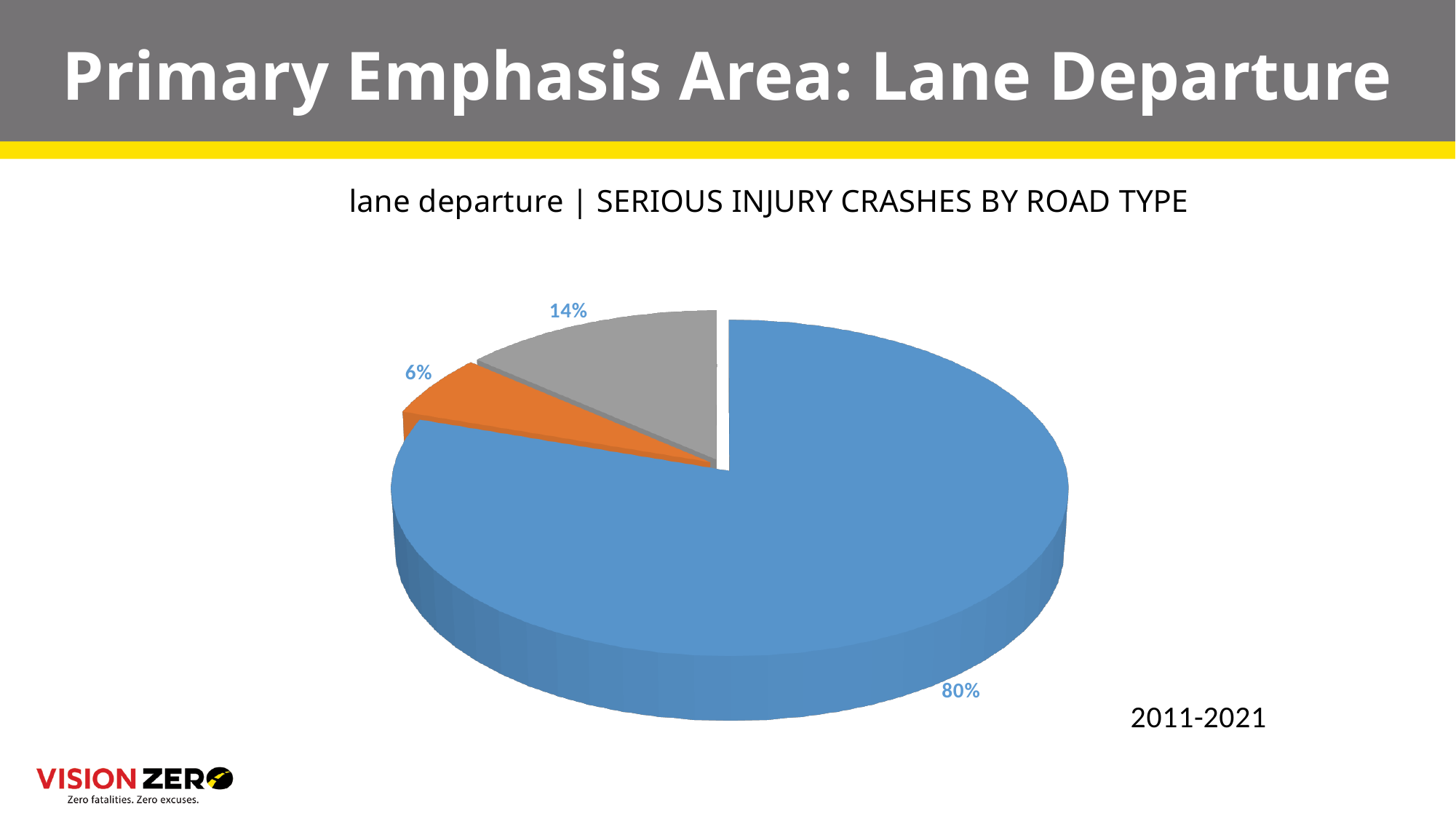
Which is larger, the grey slice or the orange slice? grey slice Which colour slice represents the smallest share of the pie chart? orange What percentage is shown for the grey slice of the pie chart? 14% What time period is shown next to the pie chart? 2011-2021 What is the difference in percentage points between the blue slice and the grey slice? 66 What percentage is shown for the blue slice of the pie chart? 80% What percentage is shown for the orange slice of the pie chart? 6% What kind of chart is shown on the slide? pie chart Which colour slice represents the largest share of the pie chart? blue What is the difference in percentage points between the grey slice and the orange slice? 8 How many slices does the pie chart have? 3 What is the title of the pie chart? lane departure | SERIOUS INJURY CRASHES BY ROAD TYPE